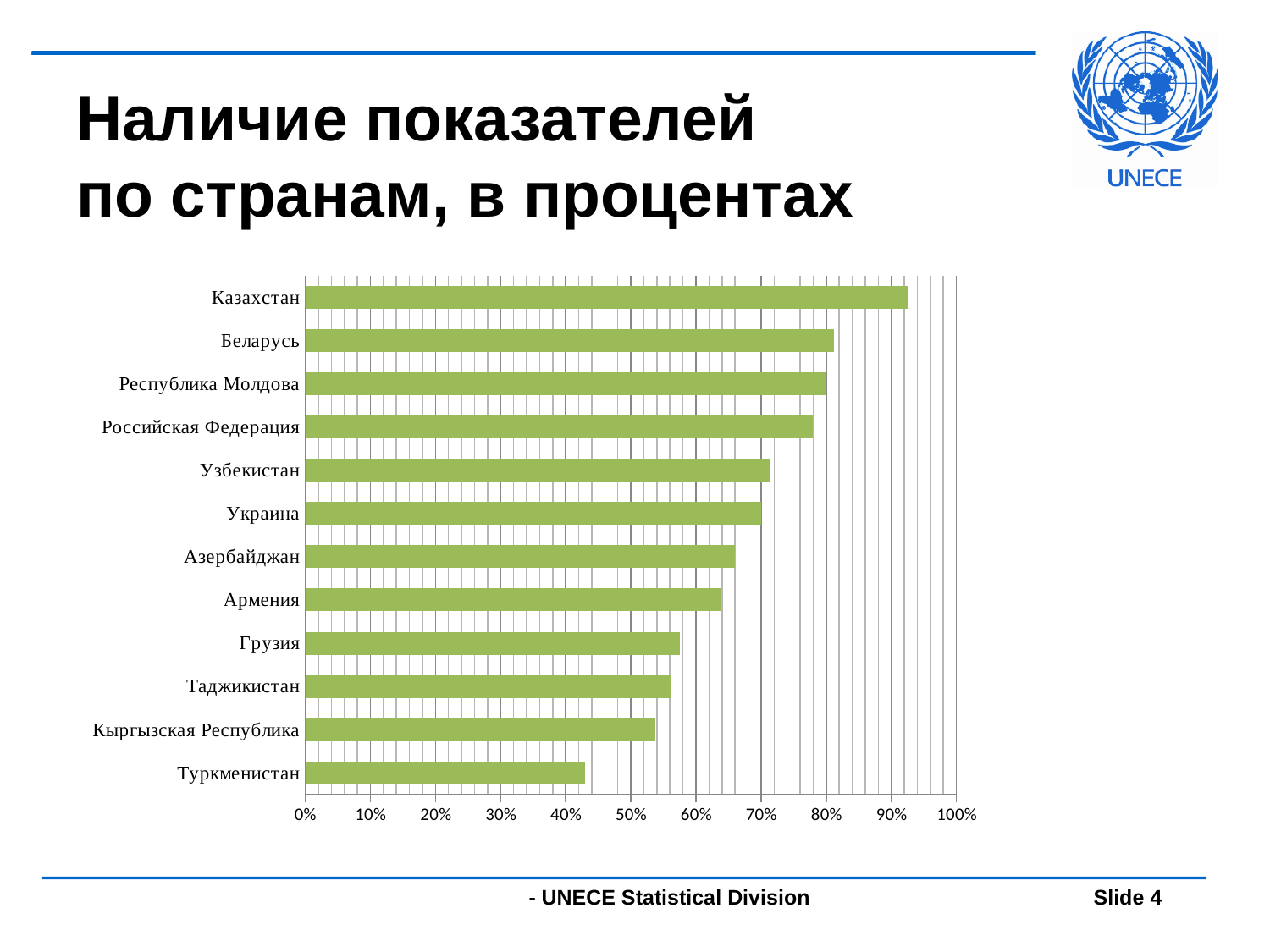
Which country has the lowest value in the chart? Туркменистан Which has a larger value, Беларусь or Грузия? Беларусь Is the value for Армения greater or less than 60%? greater Which has a larger value, Туркменистан or Узбекистан? Узбекистан Is the value for Кыргызская Республика greater or less than 60%? less What kind of chart is shown on the slide? bar chart Is the value for Туркменистан greater or less than 50%? less What is the title of the slide containing the chart? Наличие показателей по странам, в процентах Which country has the highest value in the chart? Казахстан How many countries are shown in the chart? 12